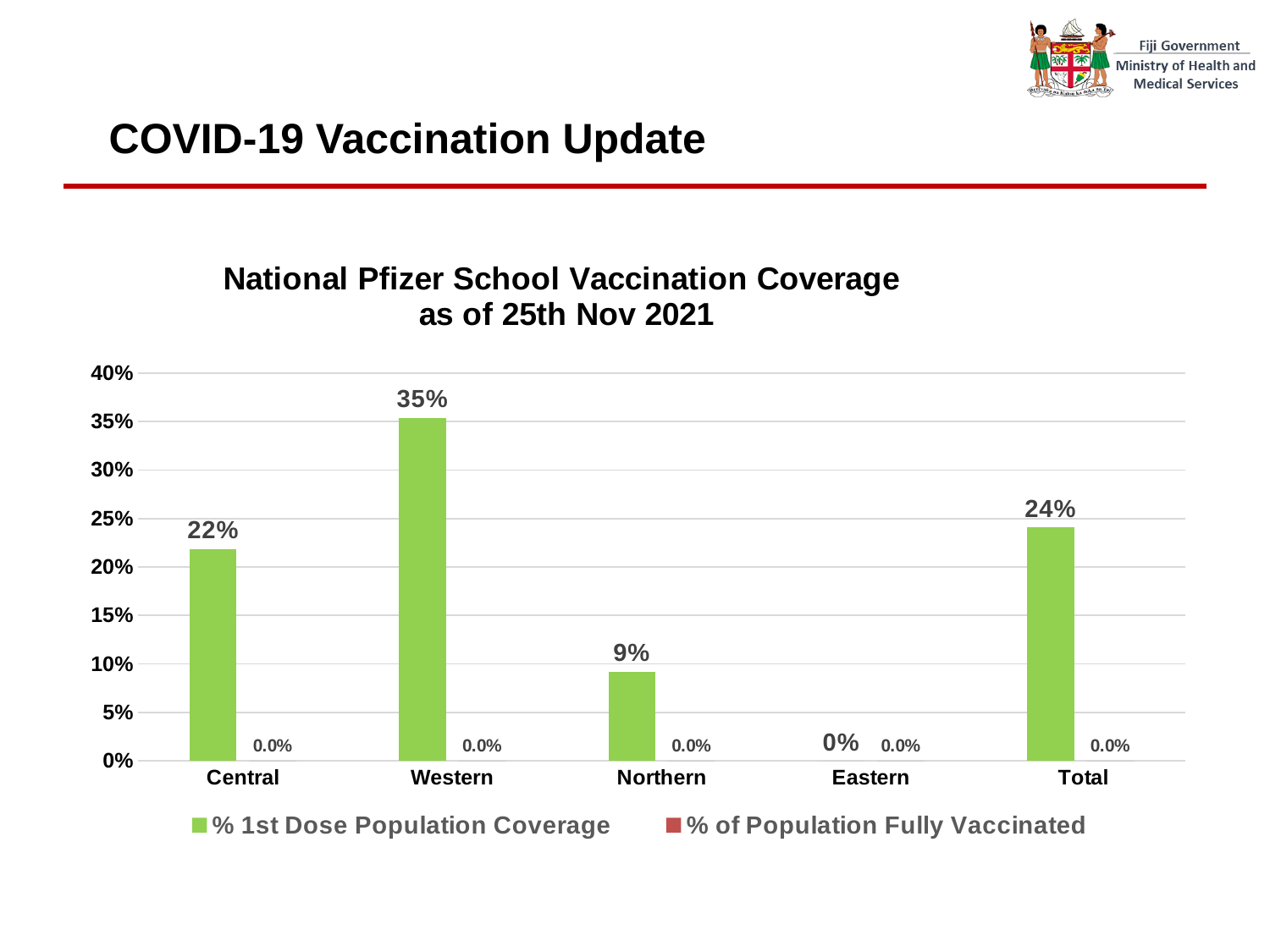
How many series does the legend list? 2 Which division has the highest % 1st Dose Population Coverage? Western How many categories are shown on the x axis? 5 Which has a higher % 1st Dose Population Coverage, Central or Total? Total What is the % 1st Dose Population Coverage for Western? 35% What type of chart is shown? Bar chart What is the % 1st Dose Population Coverage for Central? 22% What is the difference in % 1st Dose Population Coverage between Western and Central? 13% Is the % 1st Dose Population Coverage for Northern greater or less than 10%? less What is the % of Population Fully Vaccinated for Total? 0.0% Which division has the lowest % 1st Dose Population Coverage? Eastern What is the % 1st Dose Population Coverage for Northern? 9%